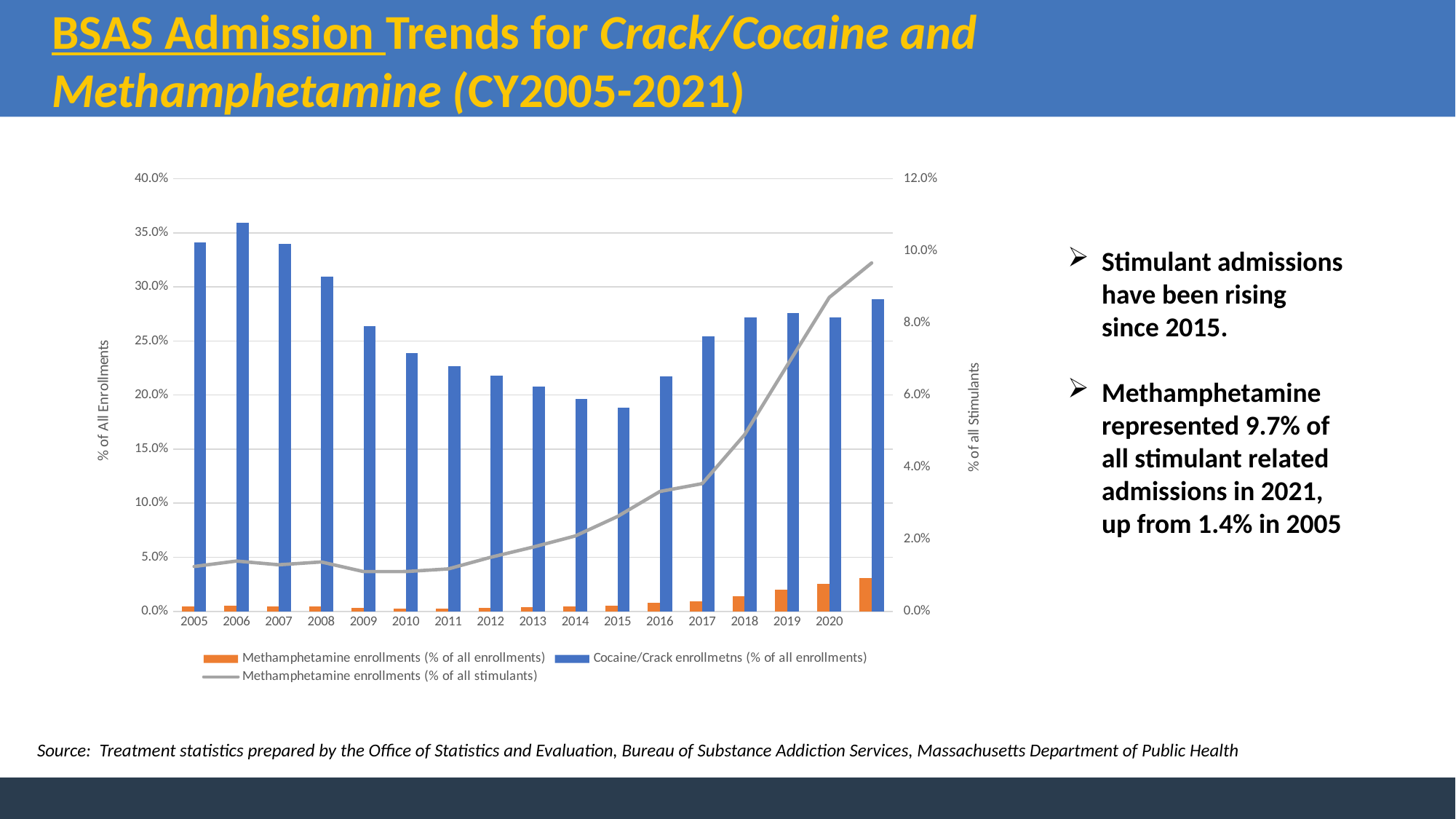
Does the Methamphetamine enrollments (% of all stimulants) line rise or fall from 2015 to the end of the series? Rises What kind of chart is shown on the slide? A combined bar and line chart Is the Methamphetamine enrollments (% of all stimulants) line value for 2017 greater or less than 4.0% on the right axis? less Is the Cocaine/Crack enrollments value for 2015 greater or less than 20.0%? less What is the title of the left vertical axis? % of All Enrollments In which year is the Cocaine/Crack enrollments bar lowest? 2015 How many series does the legend list? 3 In which year is the Cocaine/Crack enrollments bar highest? 2006 Is the Methamphetamine enrollments (% of all stimulants) line value for 2020 greater or less than 8.0% on the right axis? greater How many blue Cocaine/Crack enrollments bars are plotted? 17 Which is larger, the Cocaine/Crack enrollments bar for 2005 or for 2020? 2005